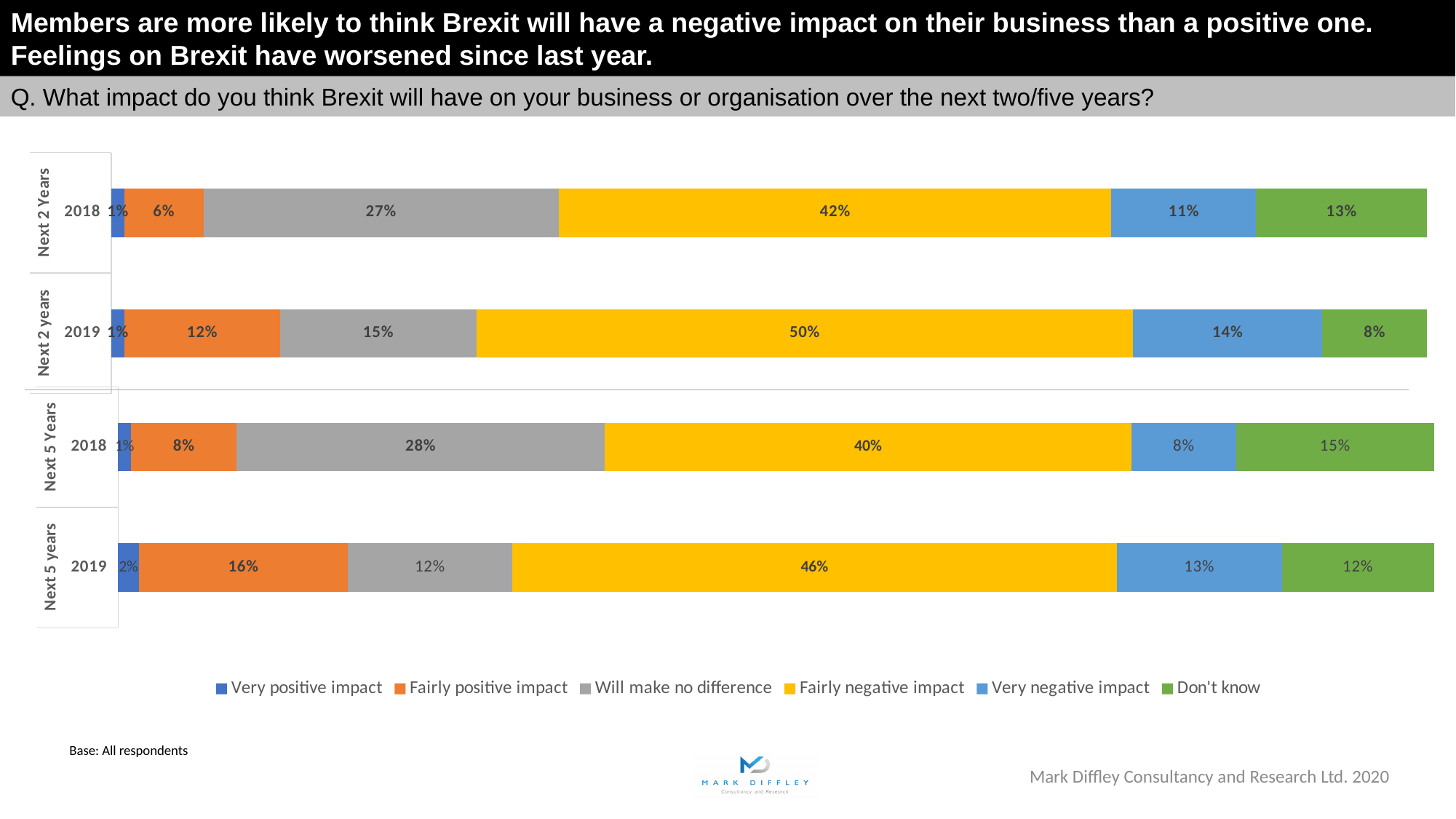
Which bar has the lowest 'Will make no difference' value? Next 5 years 2019 What kind of chart is shown on the slide? Stacked bar chart What is the 'Fairly positive impact' value for Next 5 years 2019? 16% What percentage of respondents said Brexit would have a fairly negative impact on their business over the next 2 years in 2019? 50% Which bar has the highest 'Fairly negative impact' value? Next 2 years 2019 How many series does the legend list? 6 How many bars are shown in the chart? 4 Which colour represents 'Fairly negative impact' in the chart? Yellow What is the 'Don't know' value for Next 2 Years 2018? 13% Which is larger: the 'Very negative impact' value for Next 5 Years 2018 or for Next 5 years 2019? Next 5 years 2019 What is the 'Will make no difference' value for Next 5 Years 2018? 28% What is the difference between the 'Fairly negative impact' values for Next 2 Years 2018 and Next 2 years 2019? 8 percentage points